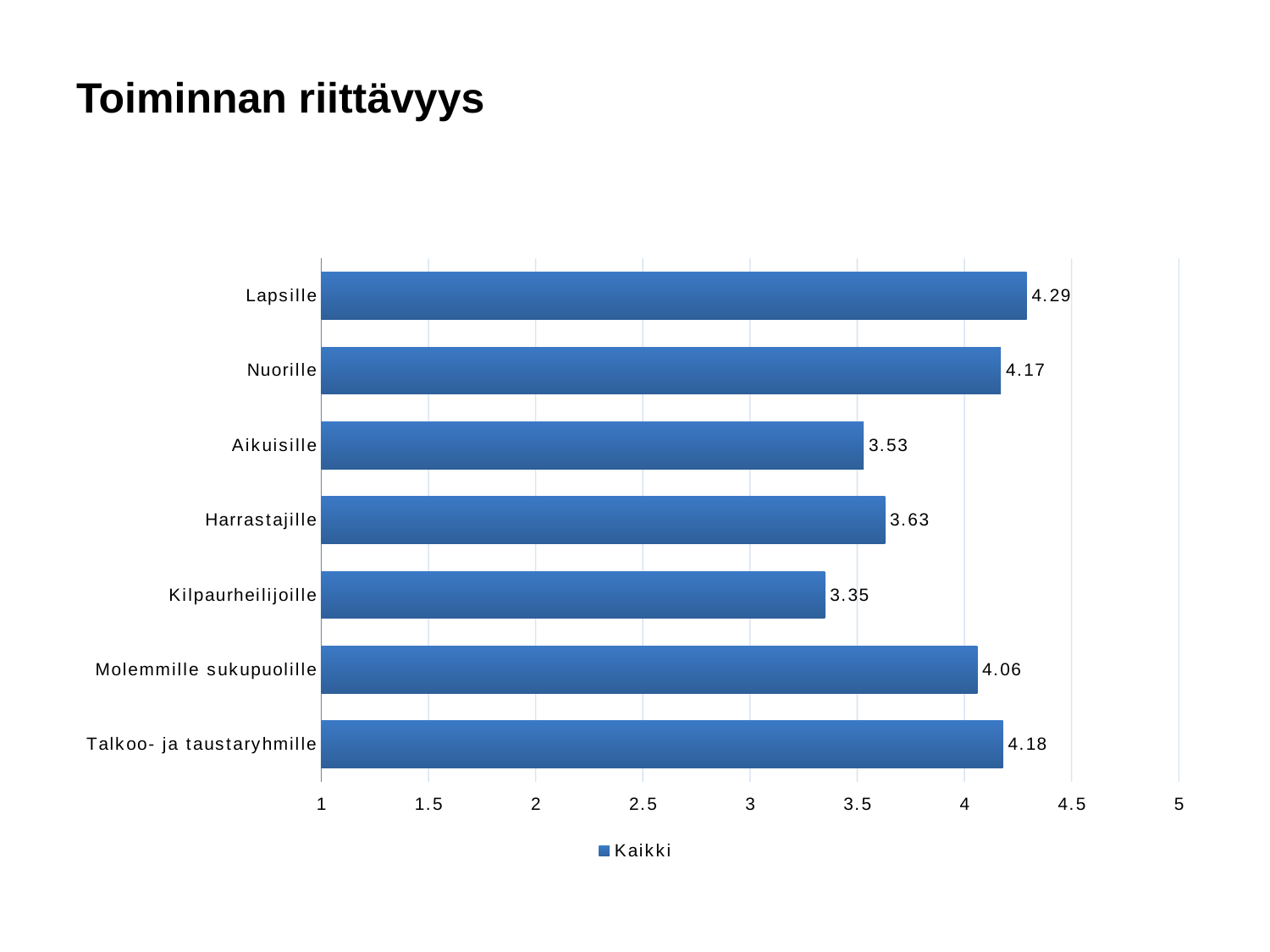
What is the value for Molemmille sukupuolille? 4.06 What is the name of the series shown in the legend? Kaikki Is the value for Nuorille greater or less than 4? greater What is the difference between the values for Lapsille and Kilpaurheilijoille? 0.94 How many categories are shown in the chart? 7 What kind of chart is shown on the slide? bar chart What is the value for Lapsille? 4.29 Which category has the highest value? Lapsille Which category has the lowest value? Kilpaurheilijoille What is the value for Kilpaurheilijoille? 3.35 How many series does the legend list? 1 Which has a larger value, Harrastajille or Aikuisille? Harrastajille